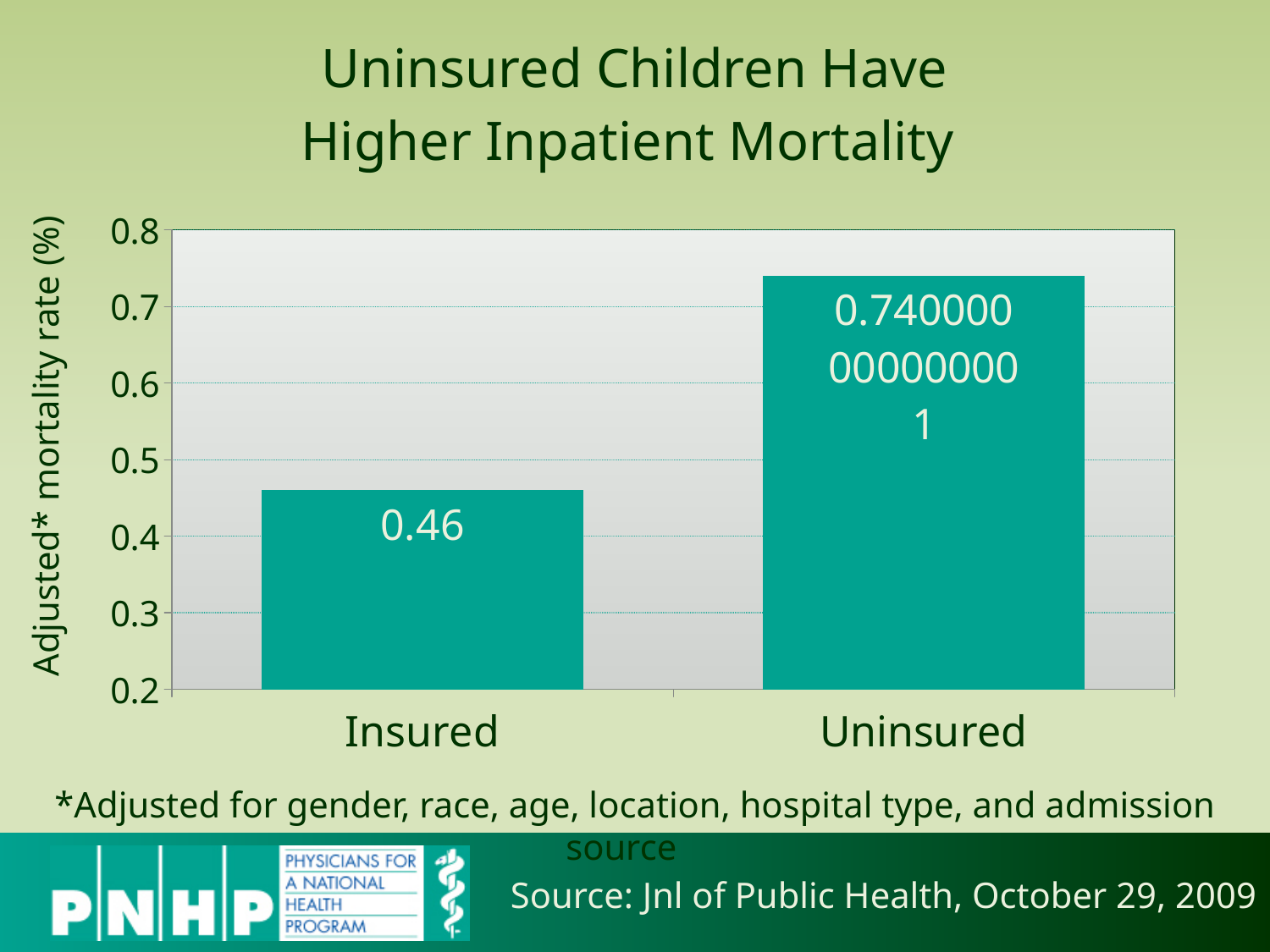
Is the adjusted mortality rate higher for Insured or Uninsured children? Uninsured What is the title of the slide? Uninsured Children Have Higher Inpatient Mortality What is the difference between the Uninsured and Insured adjusted mortality rates? 0.28 Which category has the higher adjusted mortality rate? Uninsured What is the adjusted mortality rate for Insured children? 0.46 Which category has the lower adjusted mortality rate? Insured Is the value for Insured greater or less than 0.5? less How many categories are shown on the x axis? 2 What is the label of the y axis? Adjusted* mortality rate (%) Is the value for Uninsured greater or less than 0.7? greater What is the adjusted mortality rate for Uninsured children? 0.74 What kind of chart is shown on the slide? Bar chart